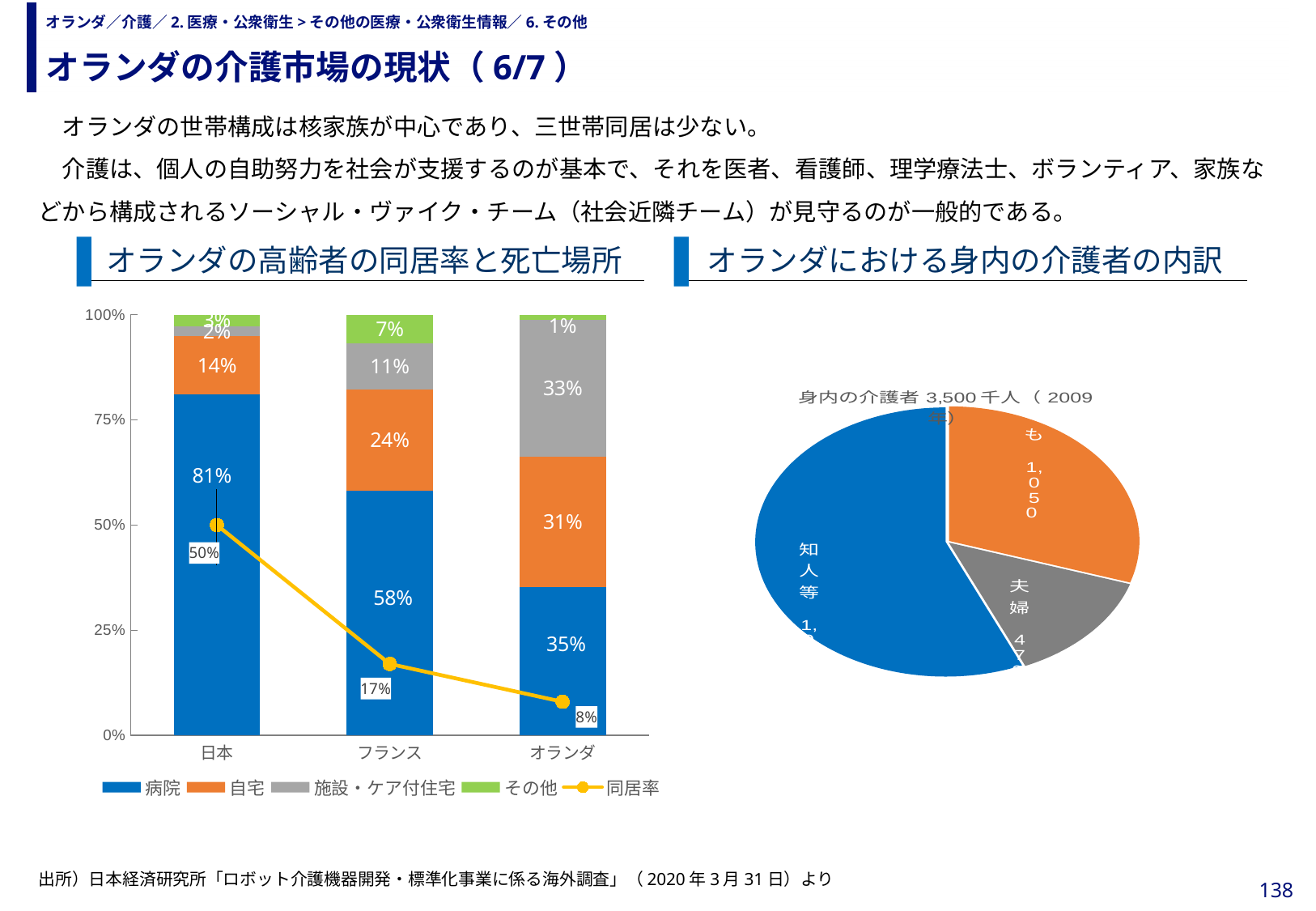
In the left chart (オランダの高齢者の同居率と死亡場所), which country has the highest 病院 value? 日本 In the left chart (オランダの高齢者の同居率と死亡場所), what is the difference between the 病院 values for 日本 and オランダ? 46% In the right chart (オランダにおける身内の介護者の内訳), which slice is the largest? 知人等 What kind of chart is the right chart (オランダにおける身内の介護者の内訳)? pie chart In the left chart (オランダの高齢者の同居率と死亡場所), what is the 自宅 value for フランス? 24% In the left chart (オランダの高齢者の同居率と死亡場所), what is the 病院 value for 日本? 81% In the left chart (オランダの高齢者の同居率と死亡場所), how many series does the legend list? 5 In the left chart (オランダの高齢者の同居率と死亡場所), which country has the lowest 同居率? オランダ In the left chart (オランダの高齢者の同居率と死亡場所), what is the 同居率 value for フランス? 17% In the left chart (オランダの高齢者の同居率と死亡場所), which is larger for オランダ: 自宅 or 施設・ケア付住宅? 施設・ケア付住宅 In the left chart (オランダの高齢者の同居率と死亡場所), what is the 施設・ケア付住宅 value for オランダ? 33% In the left chart (オランダの高齢者の同居率と死亡場所), does the 同居率 line rise or fall from 日本 to オランダ? fall